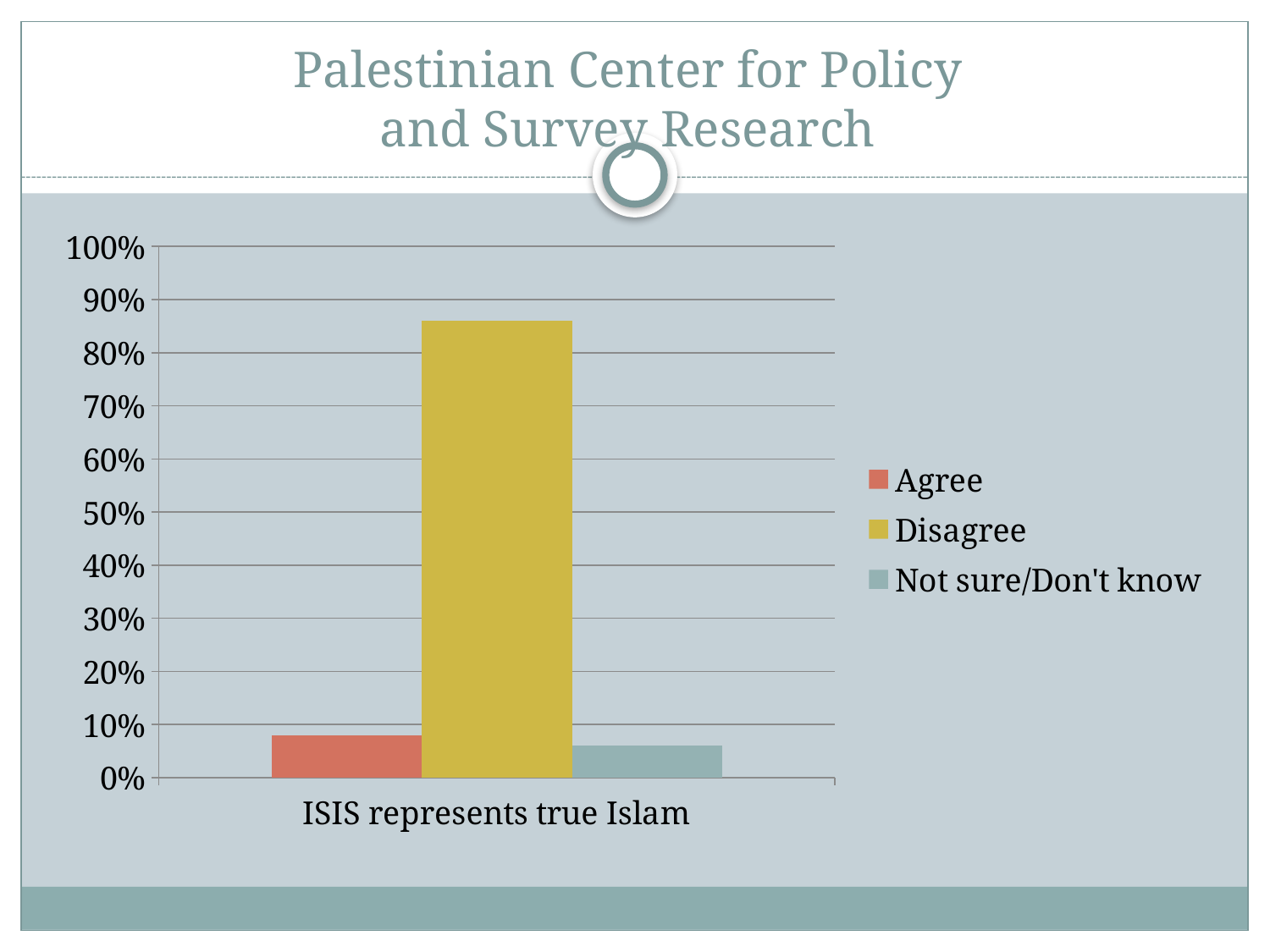
Is the value for Agree greater or less than 10%? less Which is larger, the value for Agree or the value for Disagree? Disagree Is the value for Disagree greater or less than 50%? greater Is the value for Disagree greater or less than 80%? greater What colour is the bar for Disagree? yellow Which response has the highest value for "ISIS represents true Islam"? Disagree What is the category label shown on the x axis? ISIS represents true Islam What kind of chart is shown on the slide? bar chart How many series does the legend list? 3 Which is larger, the value for Disagree or the value for Not sure/Don't know? Disagree